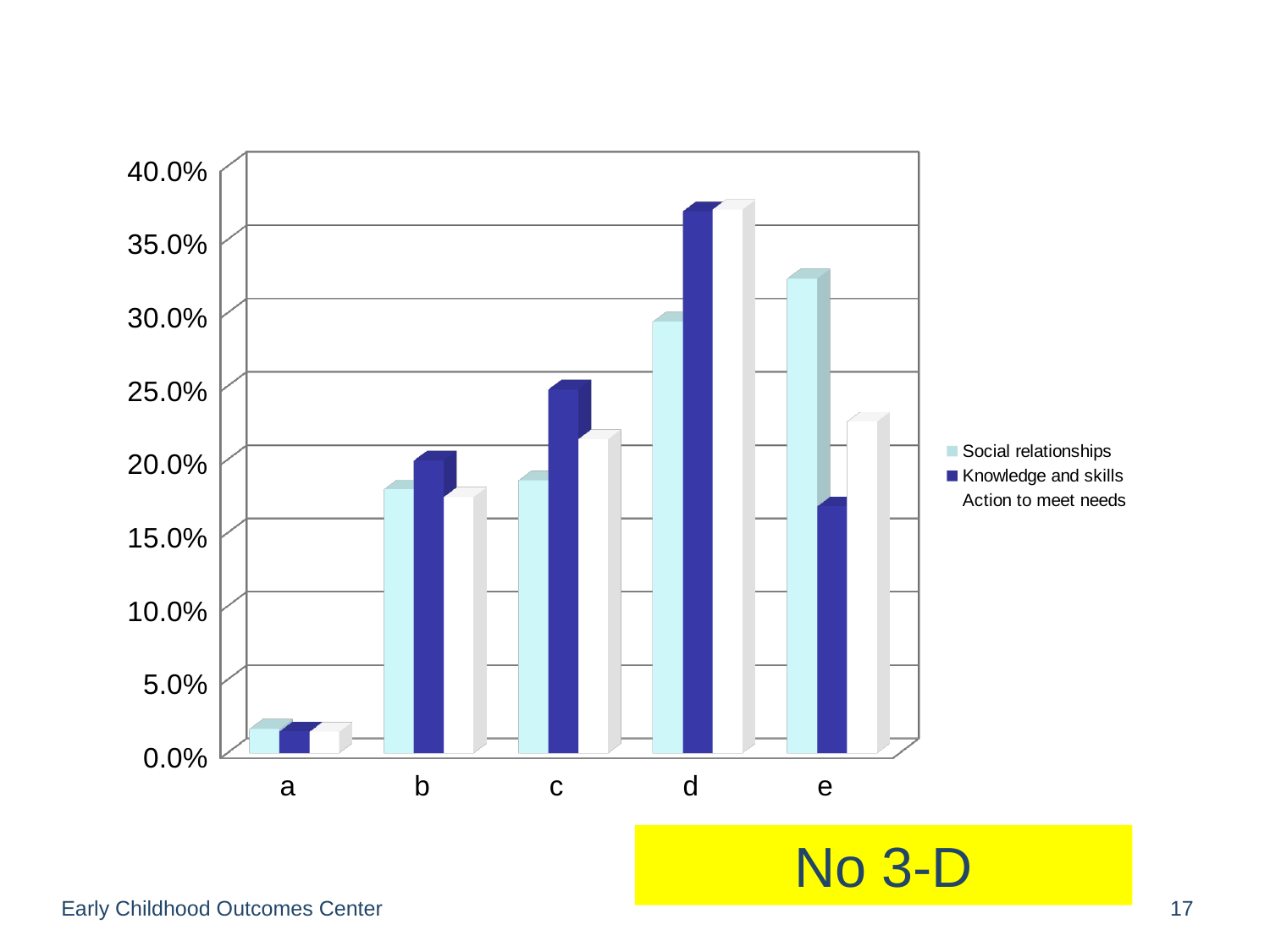
At category c, which is larger: Knowledge and skills or Social relationships? Knowledge and skills Is the value for Knowledge and skills at category e greater or less than 20.0%? less Is the value for Social relationships at category e greater or less than 30.0%? greater Which category has the highest value for Knowledge and skills? d What kind of chart is shown on the slide? bar chart Is the value for Knowledge and skills at category d greater or less than 35.0%? greater How many series does the legend list? 3 At category e, which is larger: Social relationships or Knowledge and skills? Social relationships How many categories are shown on the x axis? 5 Do the values for Knowledge and skills rise or fall from category a to category d? rise Which category has the highest value for Social relationships? e Which category has the lowest value for Action to meet needs? a